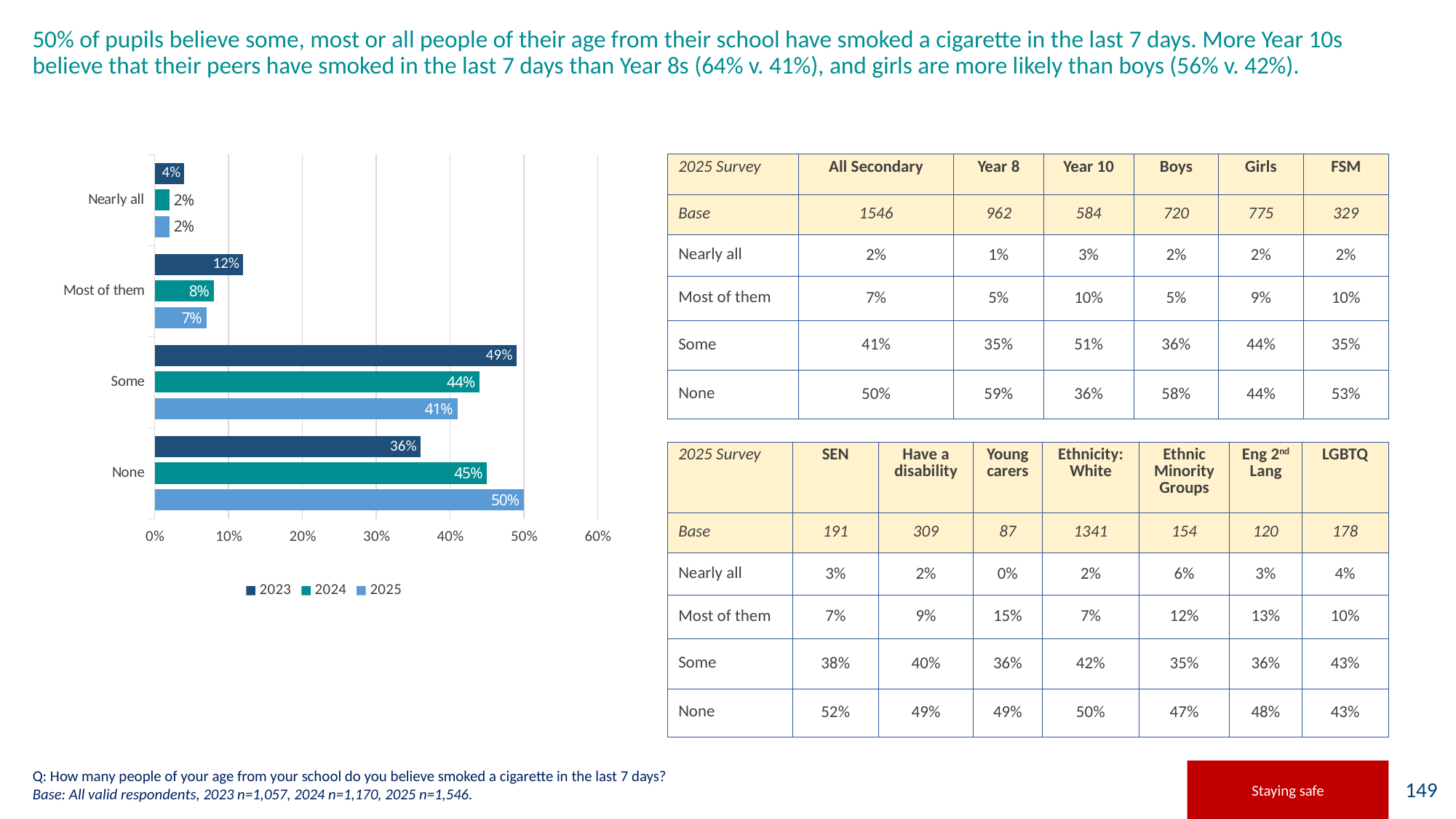
Which is larger for 'Some': the 2023 value or the 2025 value? 2023 Which series is shown in the darkest blue colour in the legend? 2023 What is the difference between the 2025 and 2023 values for 'None'? 14% Which category has the highest value in the 2025 series? None What is the value for 'None' in 2025? 50% What is the value for 'Nearly all' in 2023? 4% What kind of chart is shown on the slide? bar chart Which category has the lowest value in the 2023 series? Nearly all What is the value for 'Most of them' in 2024? 8% What is the value for 'Some' in 2023? 49% How many categories are shown on the chart? 4 How many series does the chart legend list? 3